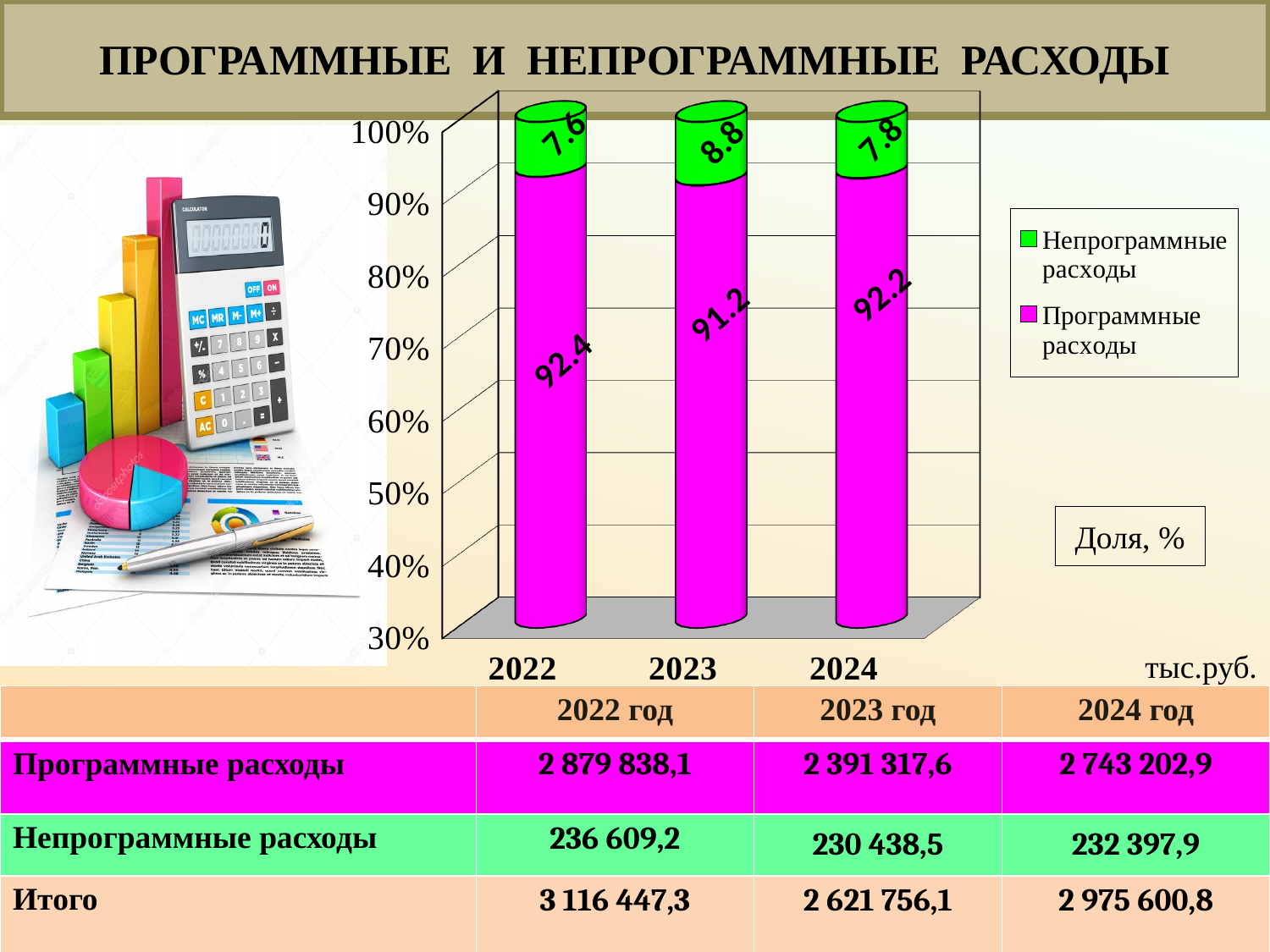
Which colour represents Непрограммные расходы in the chart? Green What is the share of Программные расходы in 2022? 92.4 In which year is the share of Программные расходы the lowest? 2023 What is the share of Непрограммные расходы in 2023? 8.8 What is the difference between the share of Программные расходы in 2022 and in 2023? 1.2 How many series does the chart legend list? 2 What kind of chart is shown on the slide? Stacked bar chart How many years are shown on the x axis of the chart? 3 Which is larger: the share of Непрограммные расходы in 2022 or in 2024? 2024 In which year is the share of Непрограммные расходы the highest? 2023 What is the share of Непрограммные расходы in 2024? 7.8 What is the share of Программные расходы in 2024? 92.2